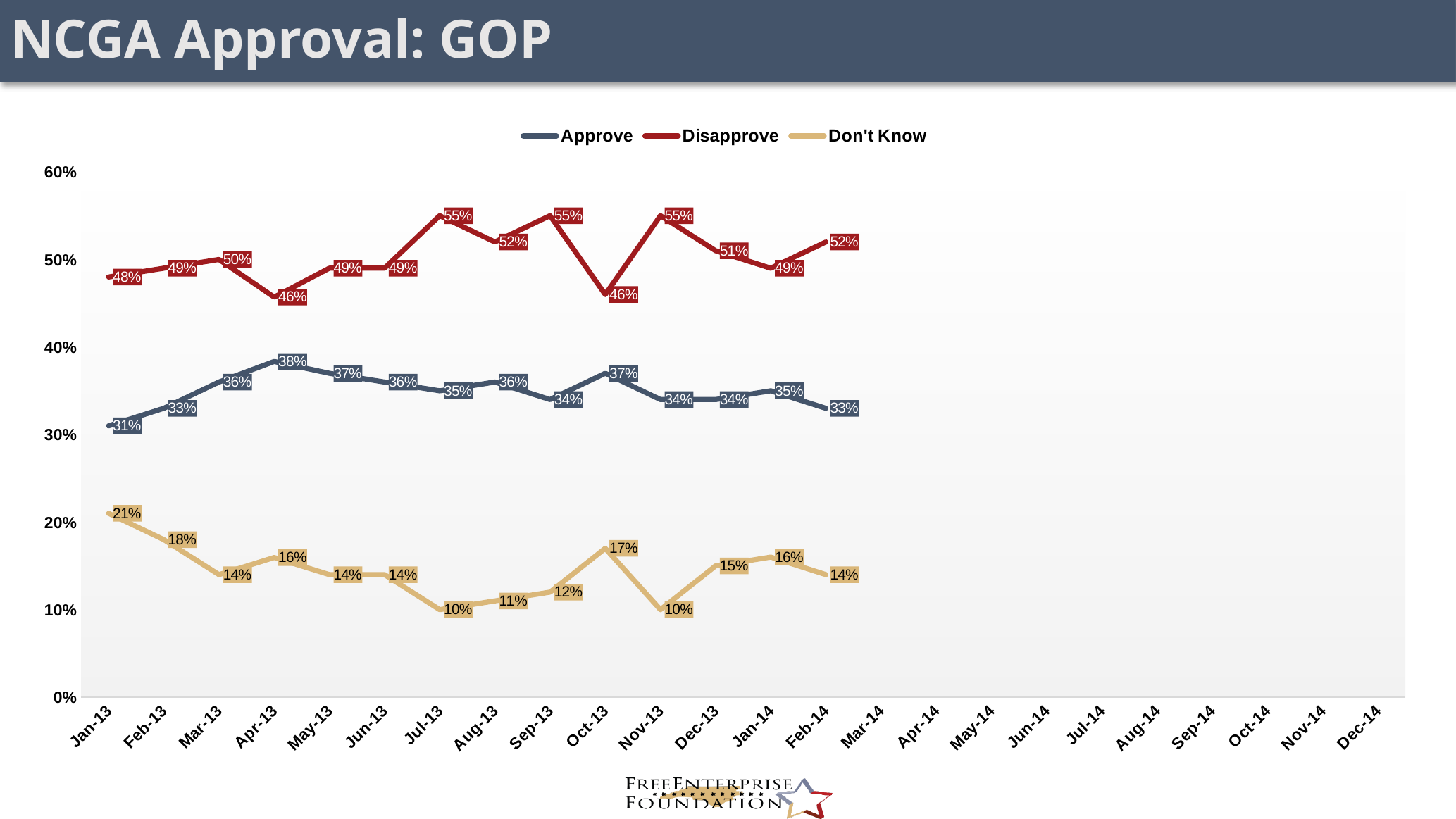
What is the Disapprove value for Jul-13? 55% What is the Approve value for Apr-13? 38% Which is larger in Oct-13, the Disapprove value or the Approve value? Disapprove What is the difference between the Disapprove and Approve values in Feb-14? 19% What is the Don't Know value for Oct-13? 17% What is the Approve value for Feb-14? 33% How many series does the legend list? 3 In which month is the Approve series at its lowest value? Jan-13 In which month is the Don't Know series at its highest value? Jan-13 What kind of chart is shown on the slide? Line chart Does the Don't Know series rise or fall from Jan-13 to Mar-13? Fall In which month does the Approve series reach its highest value? Apr-13